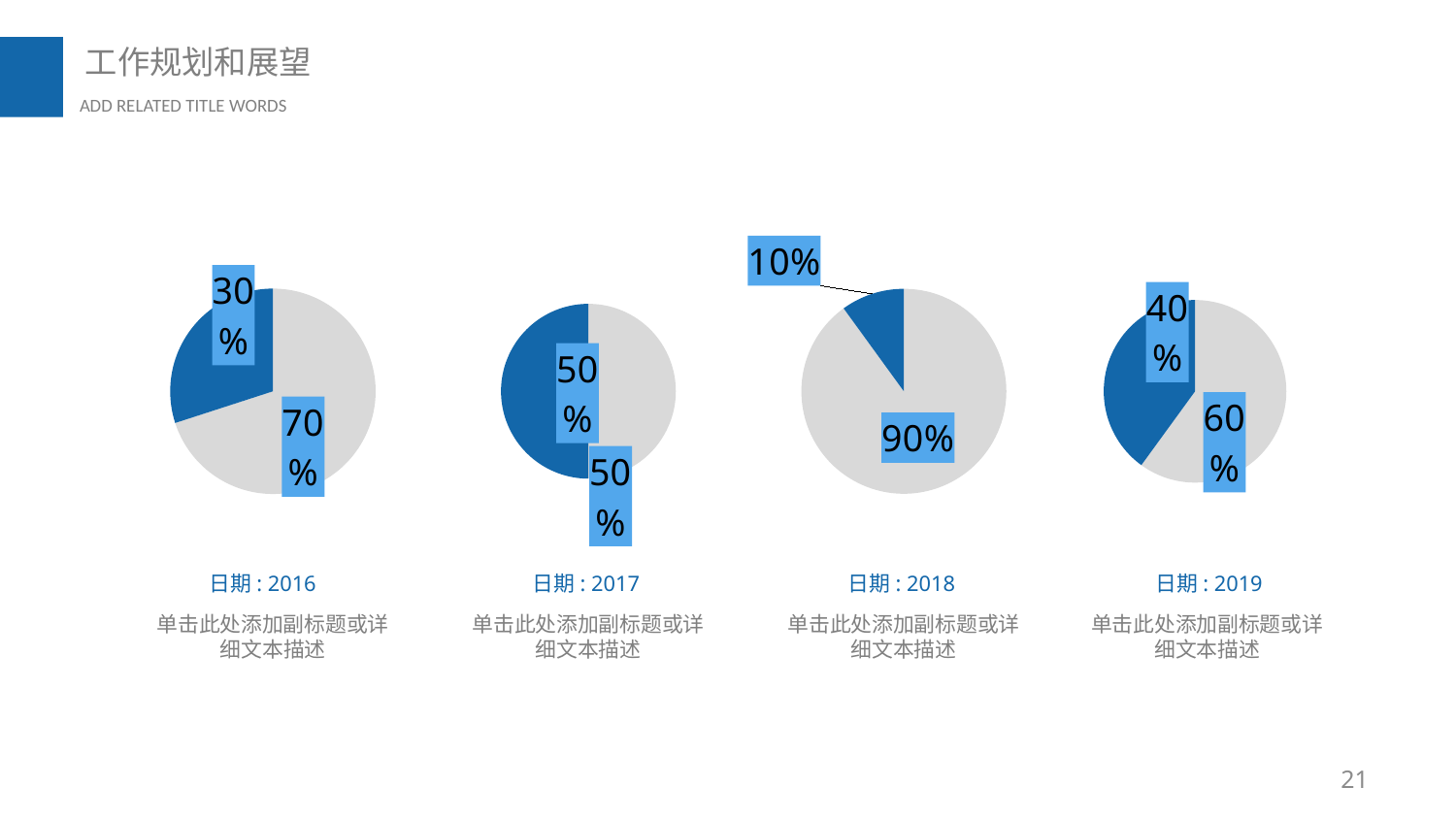
In the pie chart labelled 日期 : 2017, what share does the blue slice have? 50% In the pie chart labelled 日期 : 2016, what share does the grey slice have? 70% In the pie chart labelled 日期 : 2018, what share does the grey slice have? 90% In the pie chart labelled 日期 : 2018, what share does the blue slice have? 10% Which pie chart has the smallest blue slice? 日期 : 2018 In the pie chart labelled 日期 : 2019, what share does the grey slice have? 60% How many pie charts are on the slide? 4 In the pie chart labelled 日期 : 2016, what is the difference between the grey slice and the blue slice? 40% Which pie chart has the largest blue slice? 日期 : 2017 In the pie chart labelled 日期 : 2019, what share does the blue slice have? 40% What kind of charts are shown on the slide? Pie charts In the pie chart labelled 日期 : 2016, what share does the blue slice have? 30%